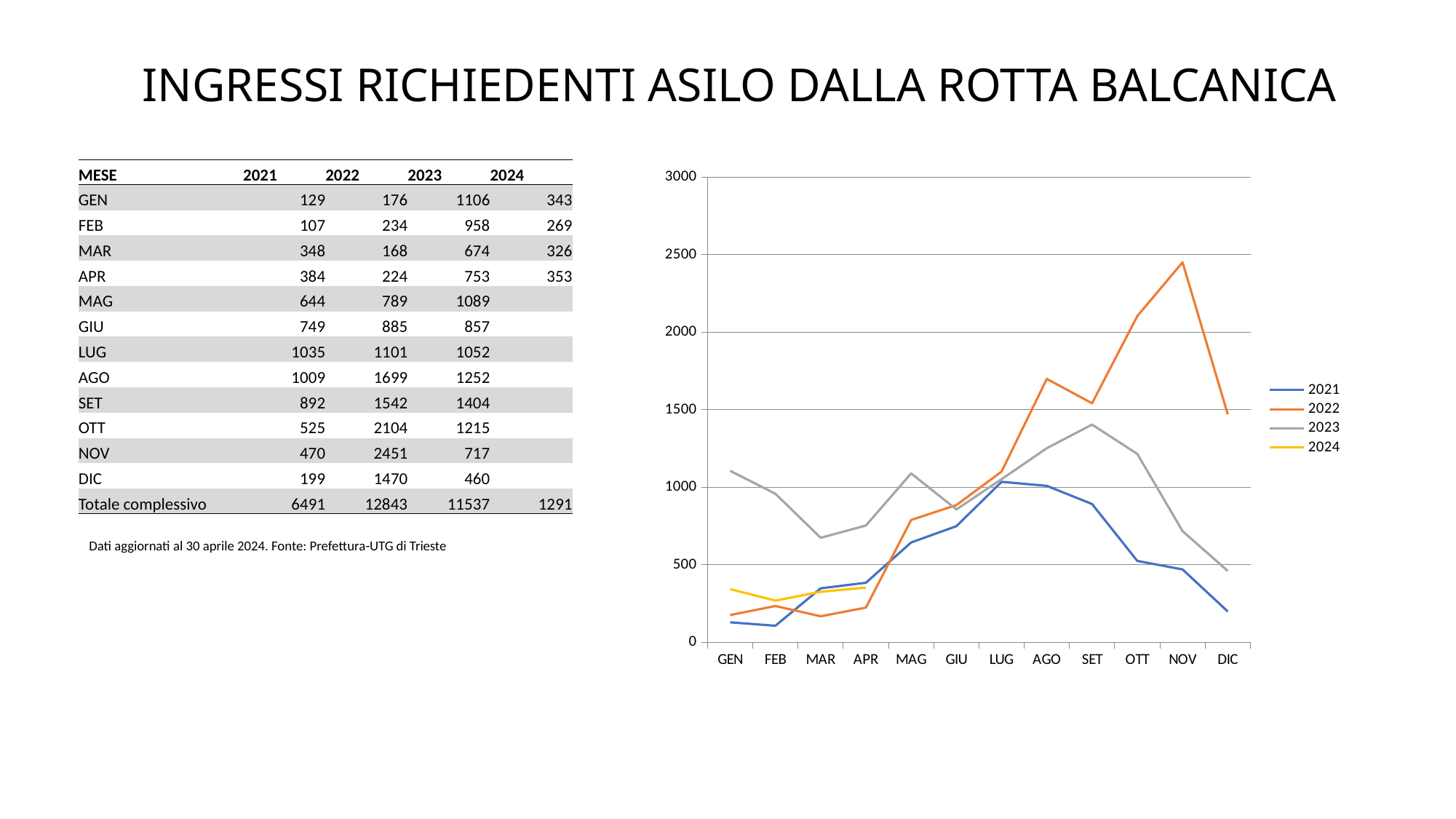
In which month does the 2022 series reach its highest value? NOV Is the value for 2023 in DIC greater or less than 500? less Which is larger in AGO: the 2022 value or the 2023 value? 2022 Is the value for 2022 in NOV greater or less than 2000? greater What kind of chart is shown on the slide? line chart According to the table, what is the value for NOV in 2022? 2451 How many series does the chart legend list? 4 In which month does the 2021 series reach its lowest value? FEB Does the 2022 series rise or fall from SET to NOV? rise How many months are shown along the x axis of the chart? 12 Using the table values, what is the difference between the 2022 and 2021 values for OTT? 1579 According to the table, what is the value for GEN in 2023? 1106